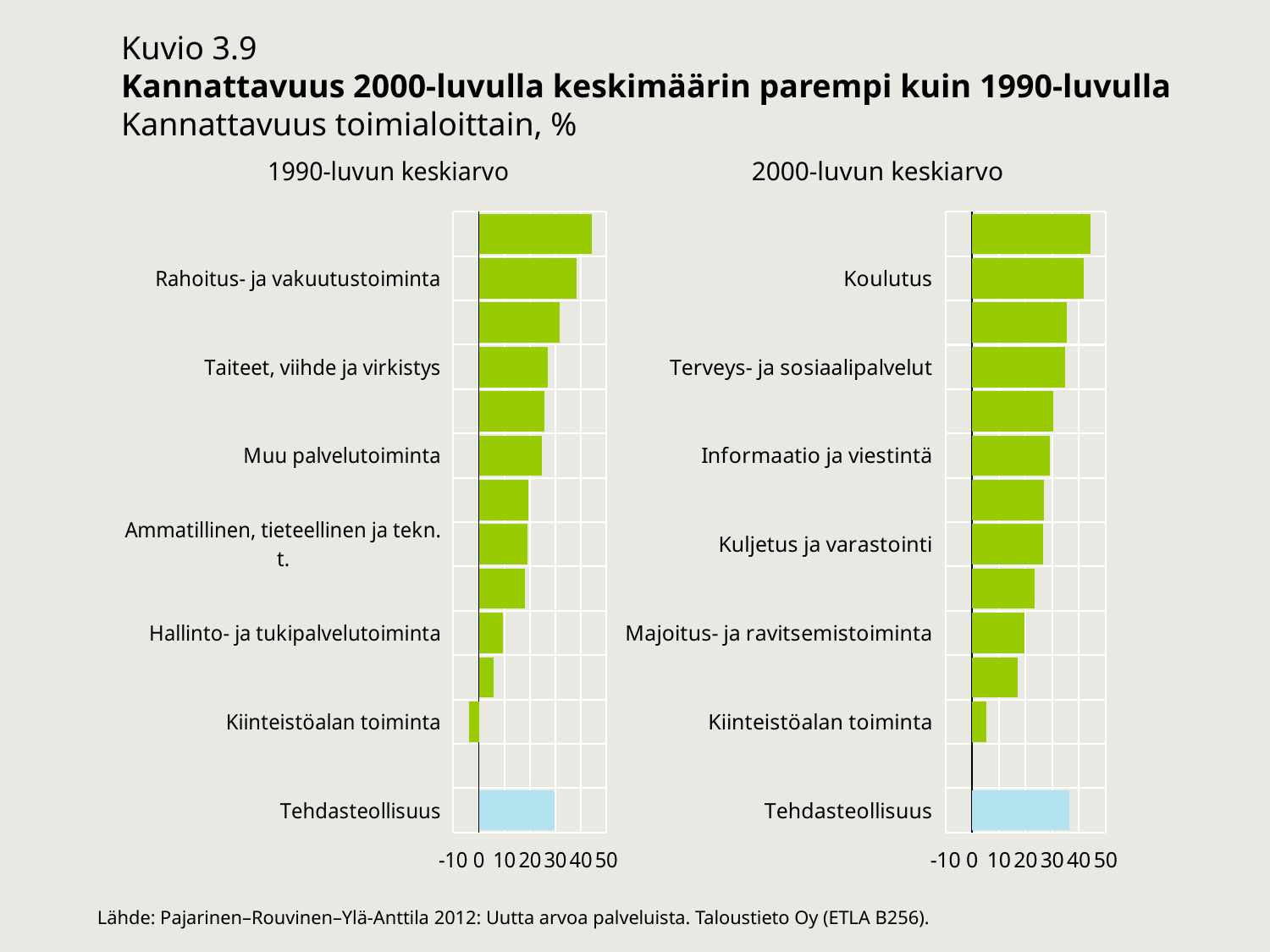
In the "2000-luvun keskiarvo" chart, is the value for Tehdasteollisuus greater or less than 30? greater In the "1990-luvun keskiarvo" chart, is the value for Kiinteistöalan toiminta greater or less than 0? less What is the highest value shown on the x axis of the "1990-luvun keskiarvo" chart? 50 In the "2000-luvun keskiarvo" chart, which labelled category has the lowest value? Kiinteistöalan toiminta In the "1990-luvun keskiarvo" chart, is the value for Hallinto- ja tukipalvelutoiminta greater or less than 20? less Is the value for Kiinteistöalan toiminta larger in the "1990-luvun keskiarvo" chart or in the "2000-luvun keskiarvo" chart? 2000-luvun keskiarvo In the "2000-luvun keskiarvo" chart, which is larger: Koulutus or Majoitus- ja ravitsemistoiminta? Koulutus In the "1990-luvun keskiarvo" chart, which labelled category has the lowest value? Kiinteistöalan toiminta What kind of chart is the "1990-luvun keskiarvo" chart? bar chart